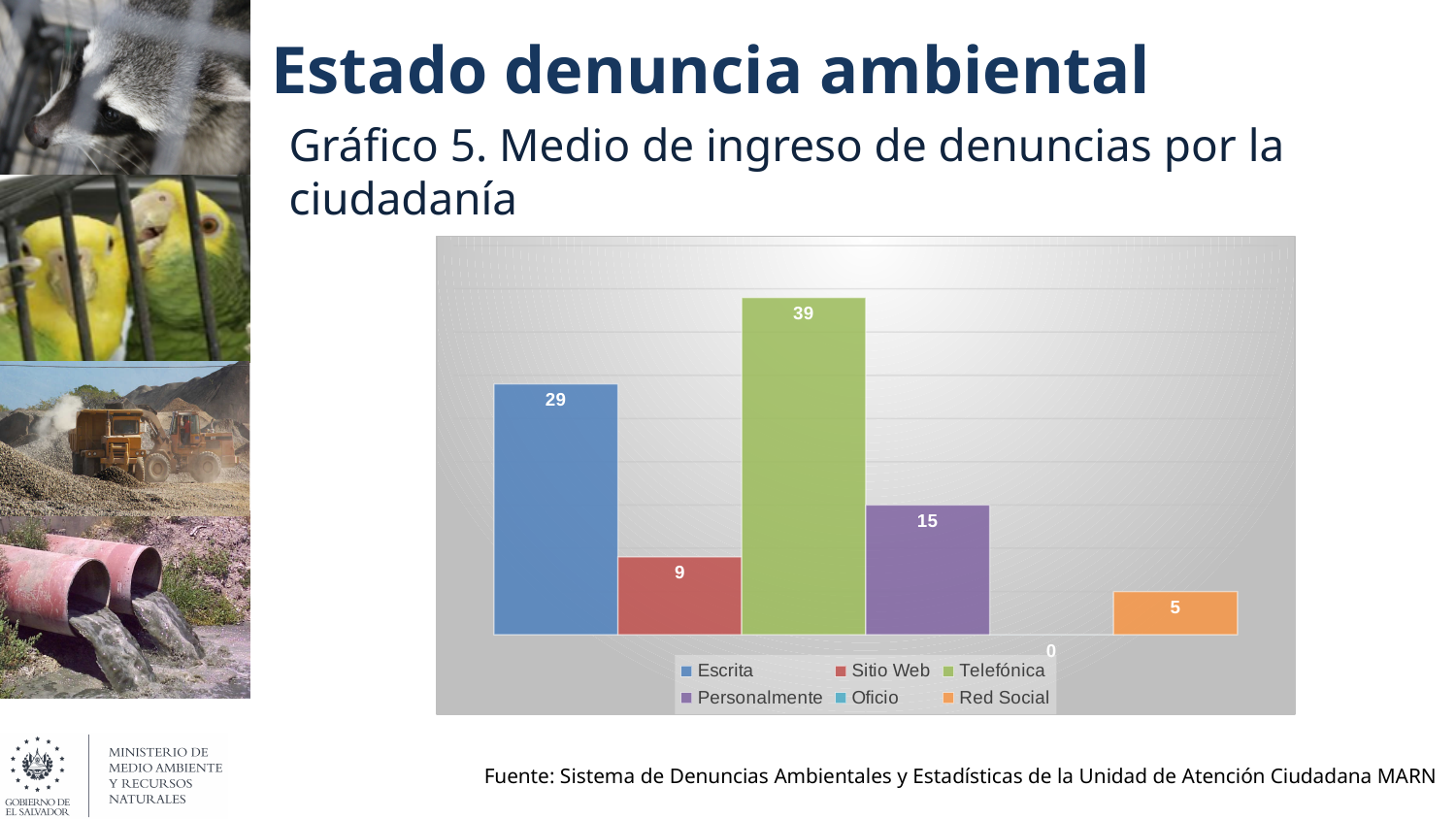
What is the value for Red Social? 5 What colour is the bar for Telefónica? Green Which is larger, the value for Personalmente or the value for Red Social? Personalmente Which medium has the highest value? Telefónica What is the value for Escrita? 29 What is the difference between the values for Telefónica and Escrita? 10 What is the value for Sitio Web? 9 How many series does the legend list? 6 What kind of chart is shown? Bar chart What is the difference between the values for Personalmente and Sitio Web? 6 What is the value for Telefónica? 39 Which medium has the lowest value? Oficio